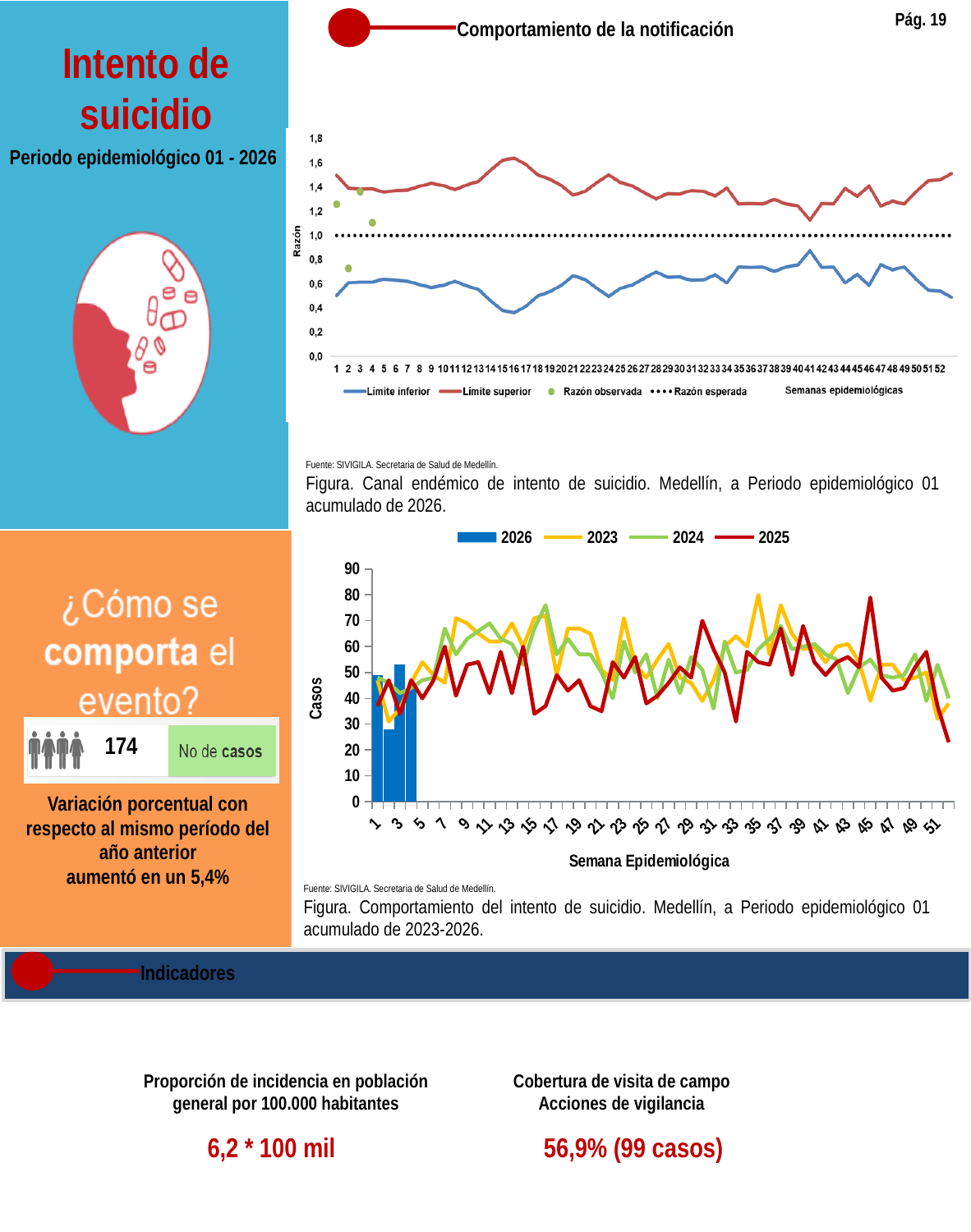
In the bottom chart (Comportamiento del intento de suicidio), which year is shown as bars rather than a line? 2026 In the top chart (Canal endémico), how many entries does the legend list? 4 In the top chart (Canal endémico), what are the legend entries? Límite inferior, Límite superior, Razón observada, Razón esperada In the top chart (Canal endémico), is the Razón observada at week 2 greater or less than 1,0? less In the top chart (Canal endémico), what kind of chart is it? line chart In the top chart (Canal endémico), is the Límite superior at week 16 greater or less than 1,4? greater In the bottom chart (Comportamiento del intento de suicidio), how many bars are plotted for 2026? 4 In the top chart (Canal endémico), at what value does the dotted Razón esperada line sit? 1,0 In the bottom chart (Comportamiento del intento de suicidio), how many series does the legend list? 4 In the bottom chart (Comportamiento del intento de suicidio), is the 2026 bar for week 2 greater or less than 40? less In the bottom chart (Comportamiento del intento de suicidio), which 2026 bar is taller, week 2 or week 3? week 3 In the top chart (Canal endémico), how many epidemiological weeks are shown on the x axis? 52